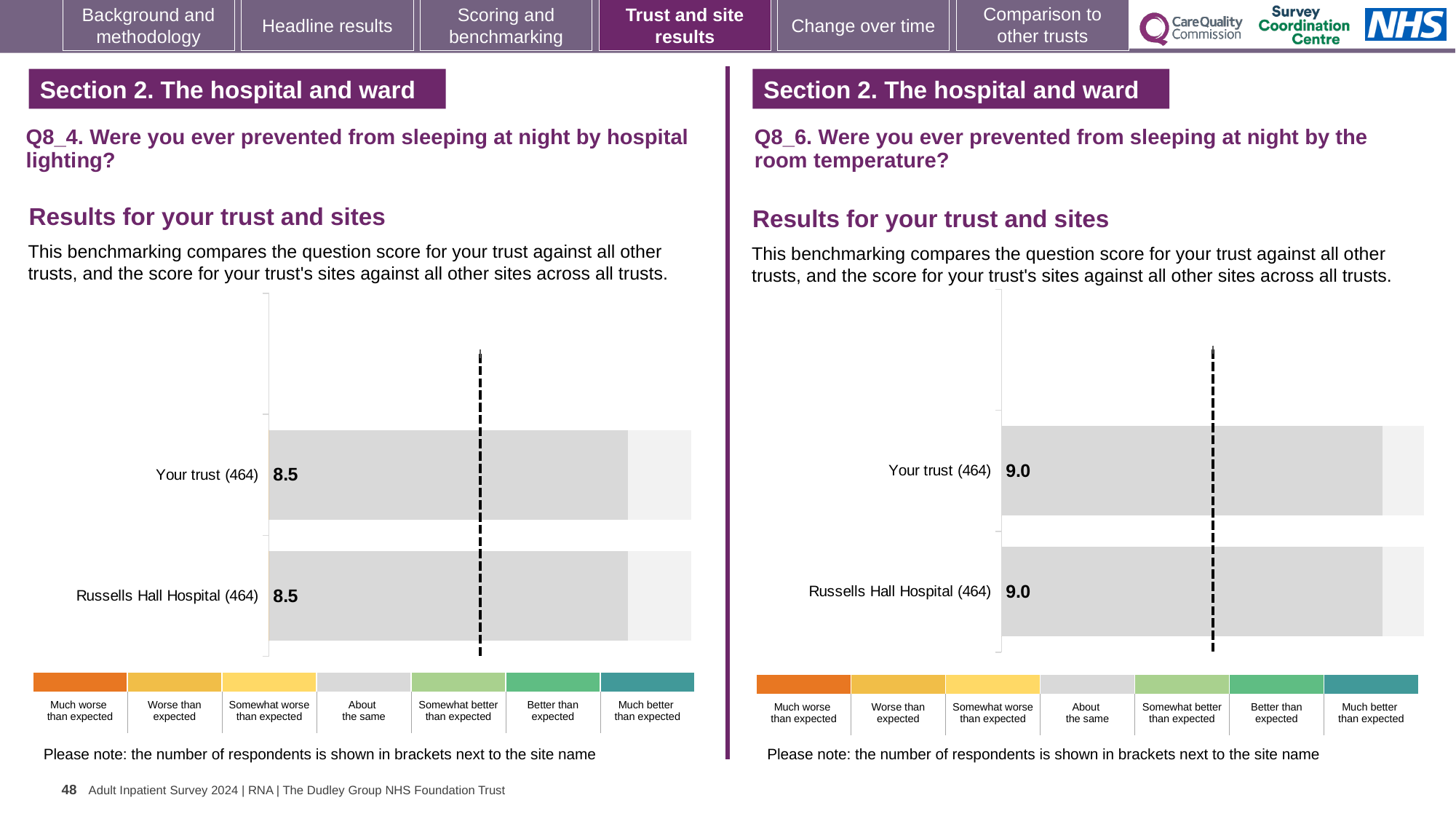
Which legend category does the grey colour of the bars in the right chart (Q8_6, room temperature) correspond to? About the same How many bars are plotted in the left chart (Q8_4, hospital lighting)? 2 In the left chart (Q8_4, hospital lighting), what is the score for Russells Hall Hospital? 8.5 How many bars are plotted in the right chart (Q8_6, room temperature)? 2 What kind of chart is used in the left chart (Q8_4, hospital lighting)? Bar chart In the right chart (Q8_6, room temperature), what is the score for Your trust? 9.0 In the right chart (Q8_6, room temperature), what is the score for Russells Hall Hospital? 9.0 In the right chart (Q8_6, room temperature), what is the difference between the score for Your trust and the score for Russells Hall Hospital? 0.0 How many categories does the colour legend below the left chart (Q8_4, hospital lighting) list? 7 In the left chart (Q8_4, hospital lighting), what is the difference between the score for Your trust and the score for Russells Hall Hospital? 0.0 In the left chart (Q8_4, hospital lighting), what is the score for Your trust? 8.5 How many respondents are shown in brackets for Your trust in the right chart (Q8_6, room temperature)? 464